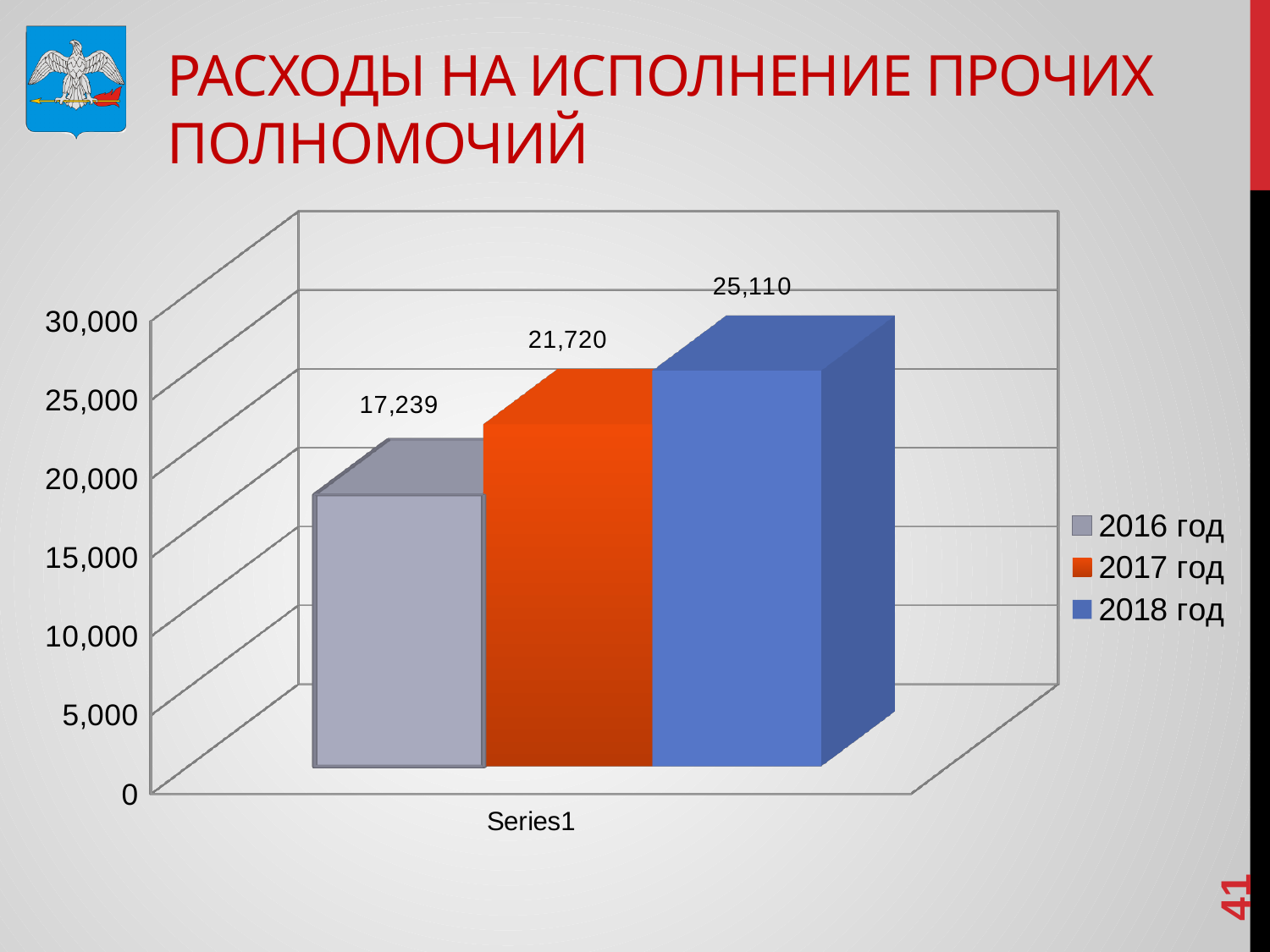
What is the value for 2018 год? 25,110 What kind of chart is shown on the slide? bar chart Which is larger, the value for 2017 год or the value for 2018 год? 2018 год Which year has the highest value? 2018 год What is the value for 2016 год? 17,239 What is the value for 2017 год? 21,720 Is the value for 2017 год greater or less than 20,000? greater What is the difference between the values for 2018 год and 2016 год? 7,871 Which year has the lowest value? 2016 год What is the difference between the values for 2017 год and 2016 год? 4,481 Do the values rise or fall from 2016 год to 2018 год? rise How many series does the legend list? 3